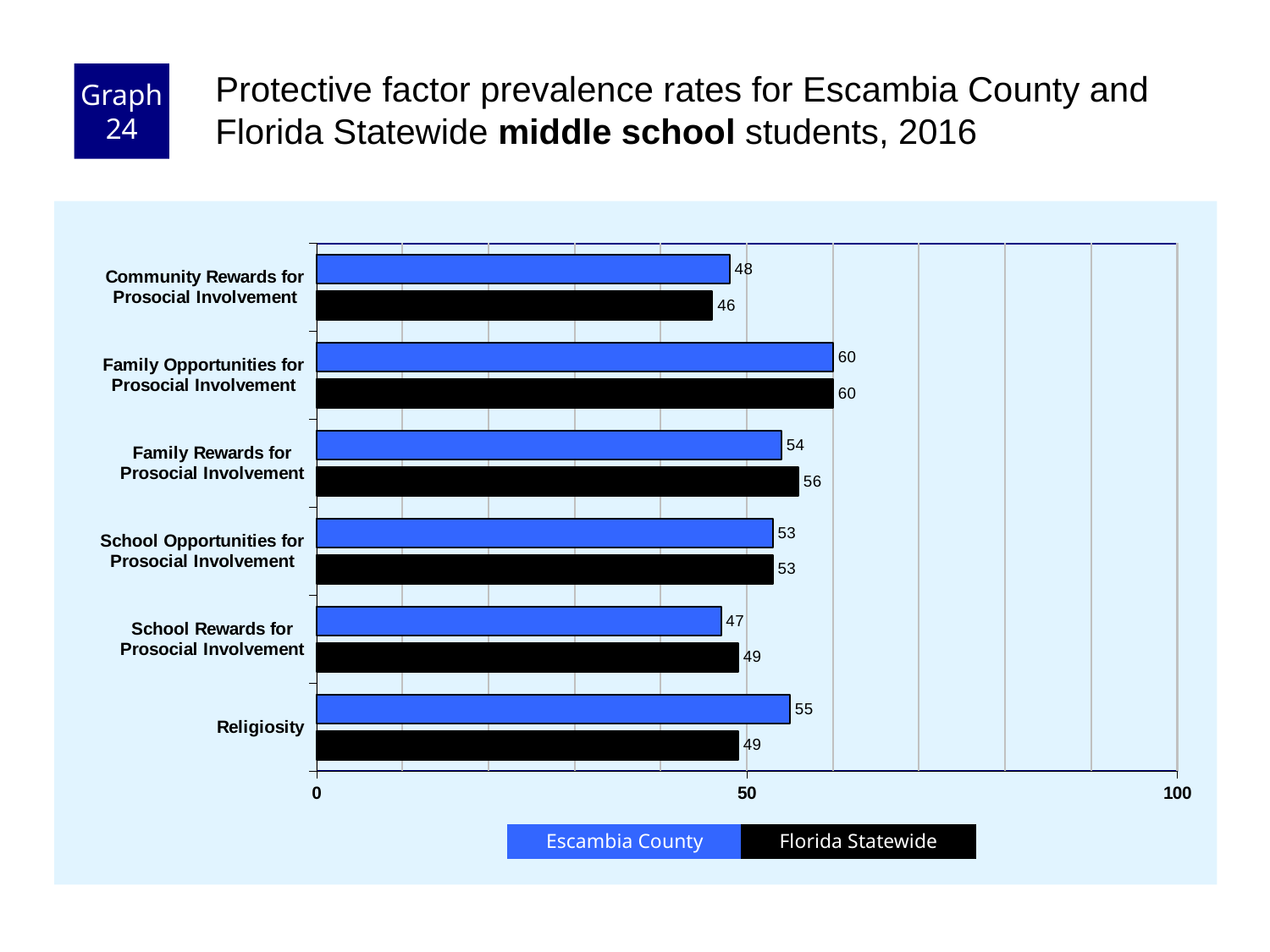
What kind of chart is shown on the slide? bar chart Which category has the lowest Florida Statewide value? Community Rewards for Prosocial Involvement What is the Florida Statewide value for Religiosity? 49 Is the Escambia County value for Family Opportunities for Prosocial Involvement greater or less than 50? greater For School Rewards for Prosocial Involvement, which is larger: Escambia County or Florida Statewide? Florida Statewide How many categories are shown on the chart? 6 What colour are the Florida Statewide bars? black What is the Florida Statewide value for Family Rewards for Prosocial Involvement? 56 What is the difference between the Escambia County and Florida Statewide values for Religiosity? 6 How many series does the legend list? 2 Which category has the highest Escambia County value? Family Opportunities for Prosocial Involvement What is the Escambia County value for Community Rewards for Prosocial Involvement? 48